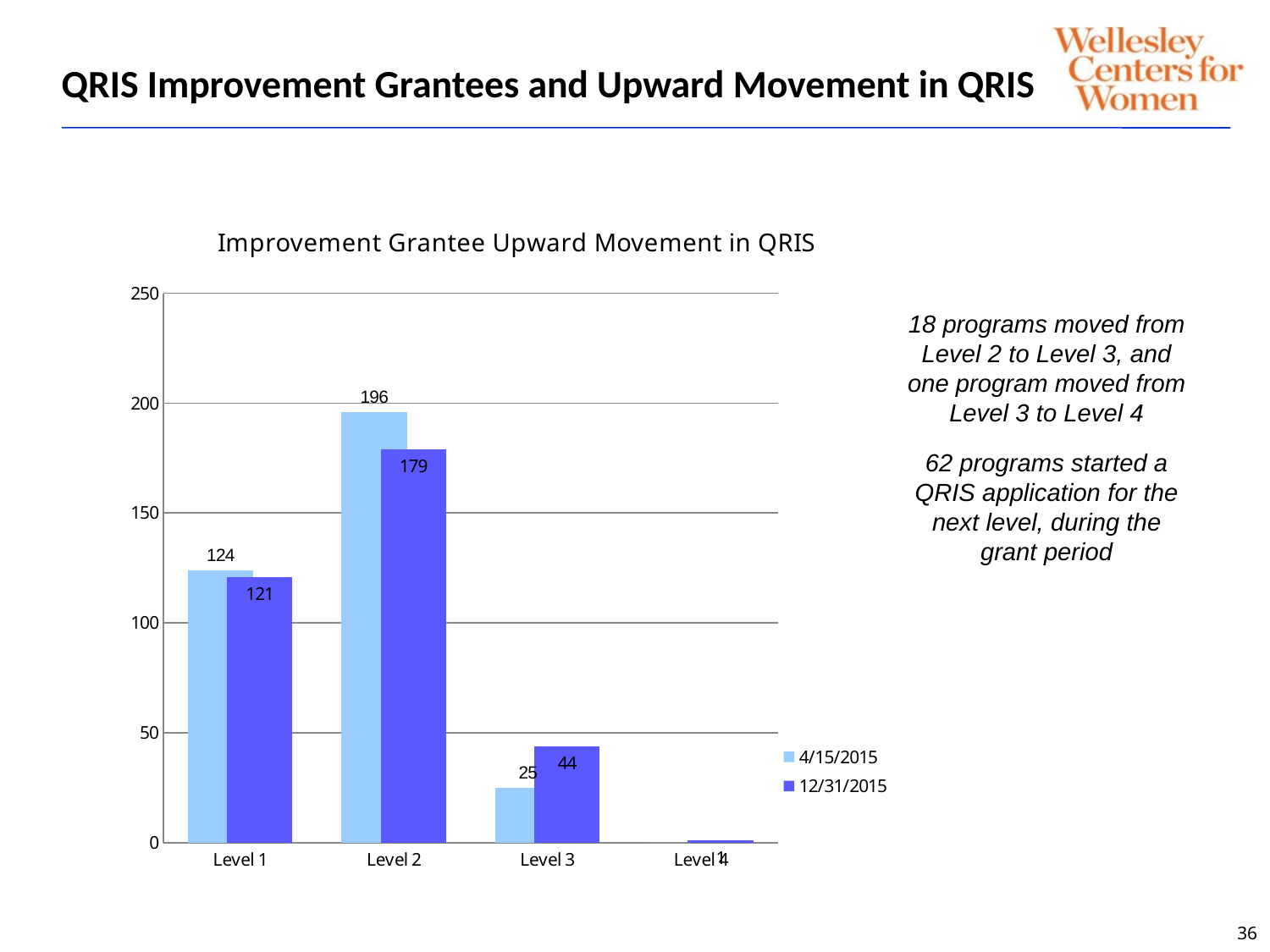
What is the title of the chart? Improvement Grantee Upward Movement in QRIS What is the difference between the 4/15/2015 and 12/31/2015 values for Level 2? 17 What is the value for Level 1 in the 12/31/2015 series? 121 What kind of chart is shown on the slide? bar chart How many levels are shown on the x axis? 4 Which level has the lowest value in the 4/15/2015 series? Level 4 What is the value for Level 3 in the 12/31/2015 series? 44 For Level 3, which series has the larger value, 4/15/2015 or 12/31/2015? 12/31/2015 What is the value for Level 2 in the 4/15/2015 series? 196 How many series does the legend list? 2 Is the 12/31/2015 value for Level 1 greater or less than 100? greater Which level has the highest value in the 12/31/2015 series? Level 2